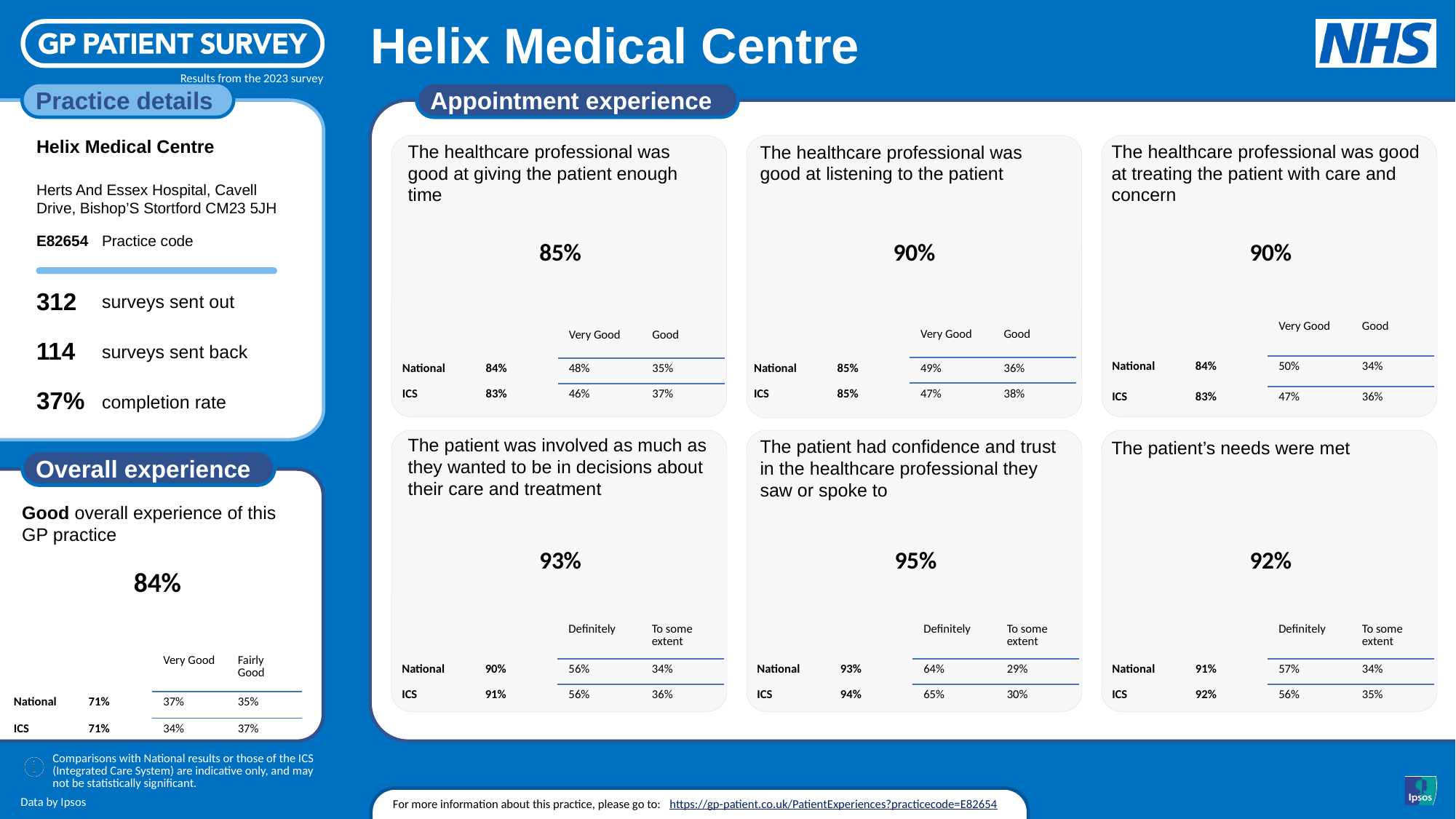
In the panel 'The healthcare professional was good at listening to the patient', what is the National 'Very Good' percentage? 49% In the panel 'The healthcare professional was good at treating the patient with care and concern', what is the ICS 'Good' percentage? 36% In the panel 'The patient was involved as much as they wanted to be in decisions about their care and treatment', which is larger: the National figure or the ICS figure? ICS In the 'Overall experience' panel, what is the National figure for good overall experience? 71% How many statement panels are shown in the 'Appointment experience' section? 6 In the panel 'The patient's needs were met', what is the difference between the practice percentage and the National percentage? 1% In the 'Appointment experience' section, which of the six statements has the lowest practice percentage? The healthcare professional was good at giving the patient enough time In the 'Appointment experience' section, what percentage is shown for 'The patient had confidence and trust in the healthcare professional they saw or spoke to'? 95% In the 'Appointment experience' section, which of the six statements has the highest practice percentage? The patient had confidence and trust in the healthcare professional they saw or spoke to In the 'Overall experience' panel, what is the ICS 'Very Good' percentage? 34% In the 'Appointment experience' section, what percentage is shown for 'The healthcare professional was good at giving the patient enough time'? 85% In the 'Overall experience' panel, what percentage of patients reported a good overall experience of this GP practice? 84%